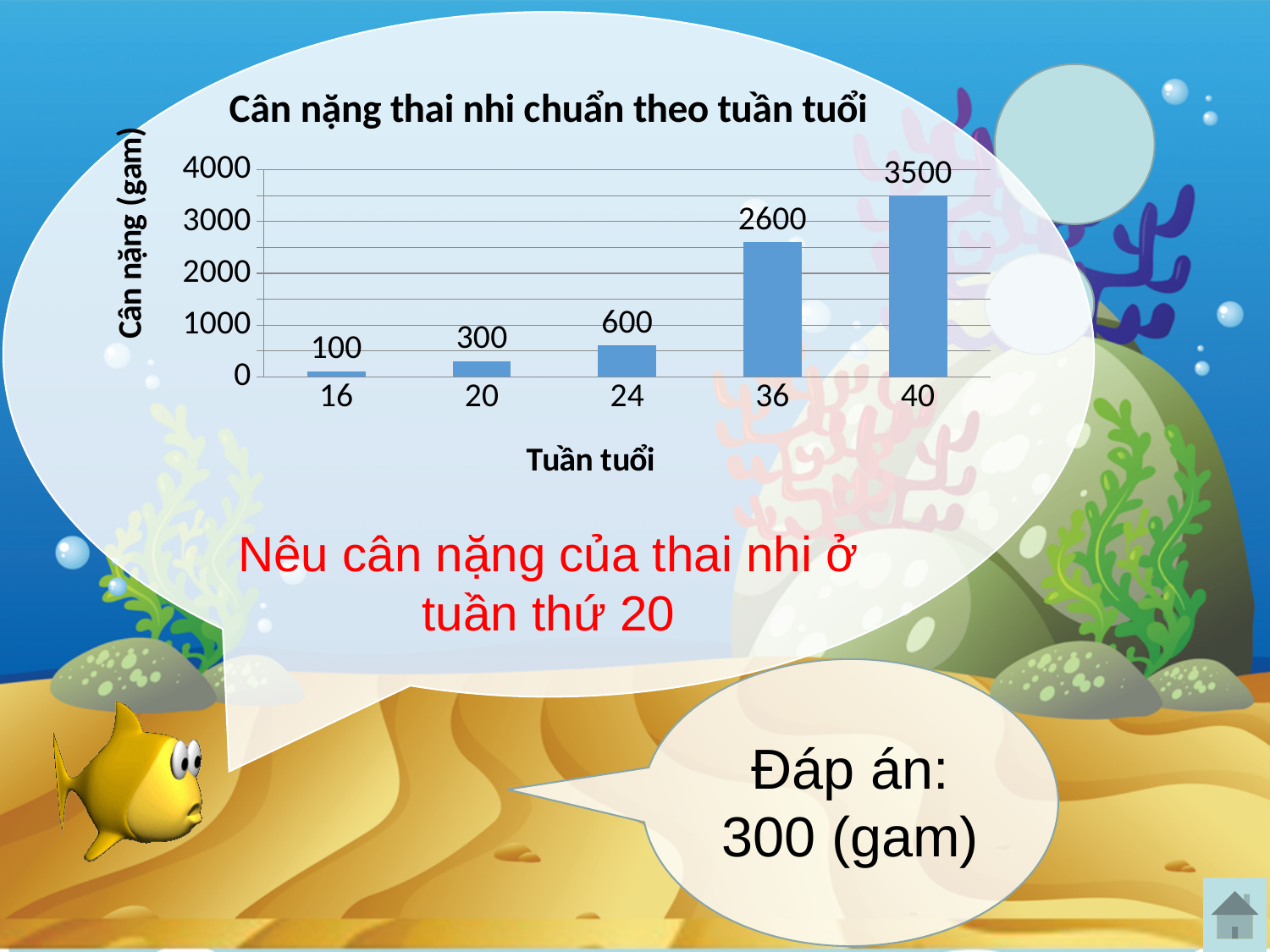
Which week has the lowest weight value? 16 What is the weight value shown for week 16? 100 What is the weight value shown for week 20? 300 What kind of chart is shown on the slide? bar chart Is the value for week 40 greater or less than 3000? greater Do the values rise or fall as the week number increases along the x axis? rise What is the weight value shown for week 36? 2600 What is the difference between the values for week 24 and week 20? 300 Which week has the highest weight value? 40 How many weeks (categories) are shown on the x axis? 5 Which is larger, the value for week 24 or the value for week 36? 36 What is the difference between the values for week 40 and week 36? 900